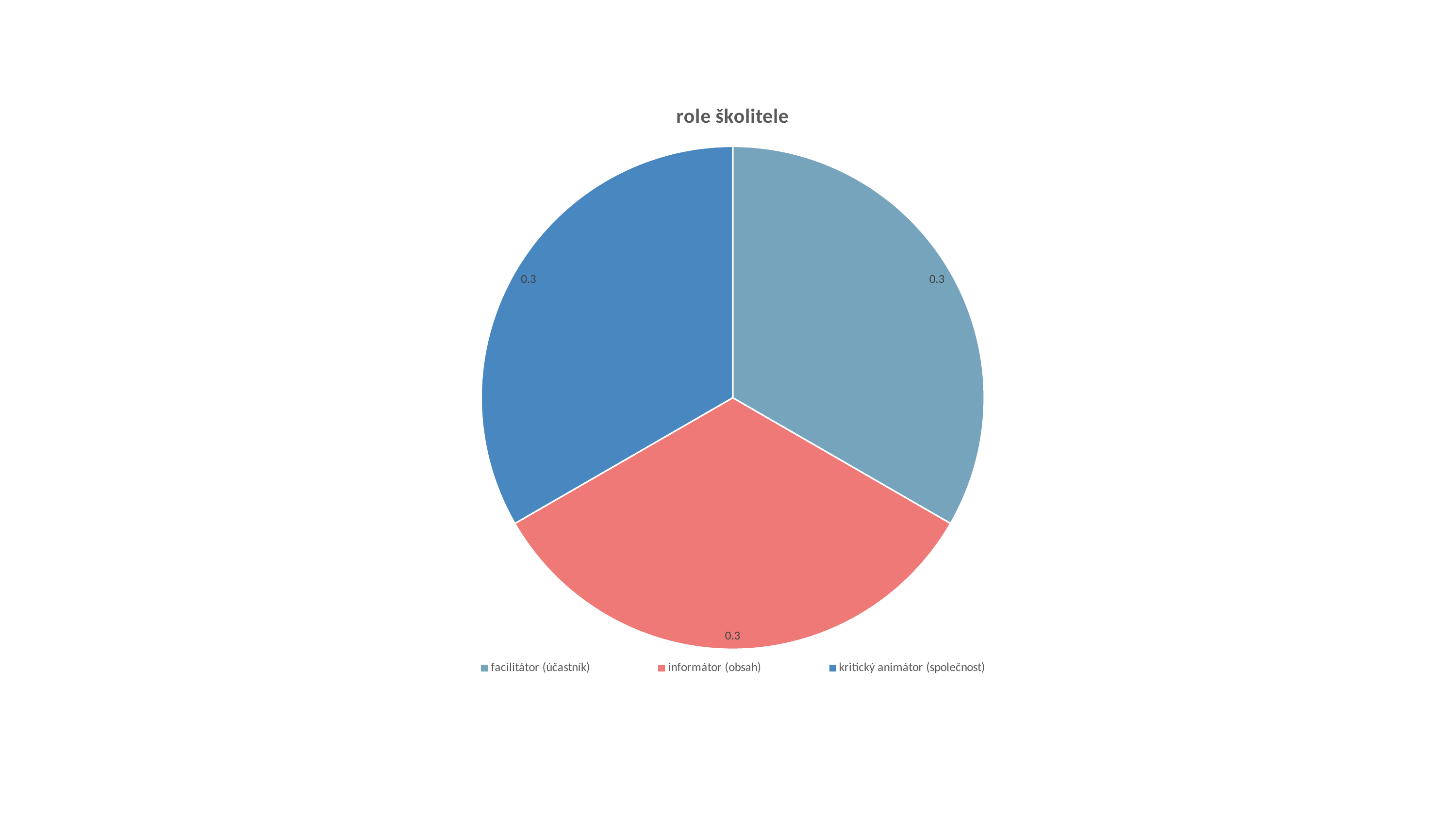
What value is shown for the kritický animátor (společnost) slice? 0.3 How many entries does the legend list? 3 What kind of chart is shown on the slide? Pie chart How many slices does the pie chart have? 3 What is the difference between the values for facilitátor (účastník) and informátor (obsah)? 0 What value is shown for the facilitátor (účastník) slice? 0.3 What is the title of the chart? role školitele What value is shown for the informátor (obsah) slice? 0.3 Which legend entry is shown in red? informátor (obsah)